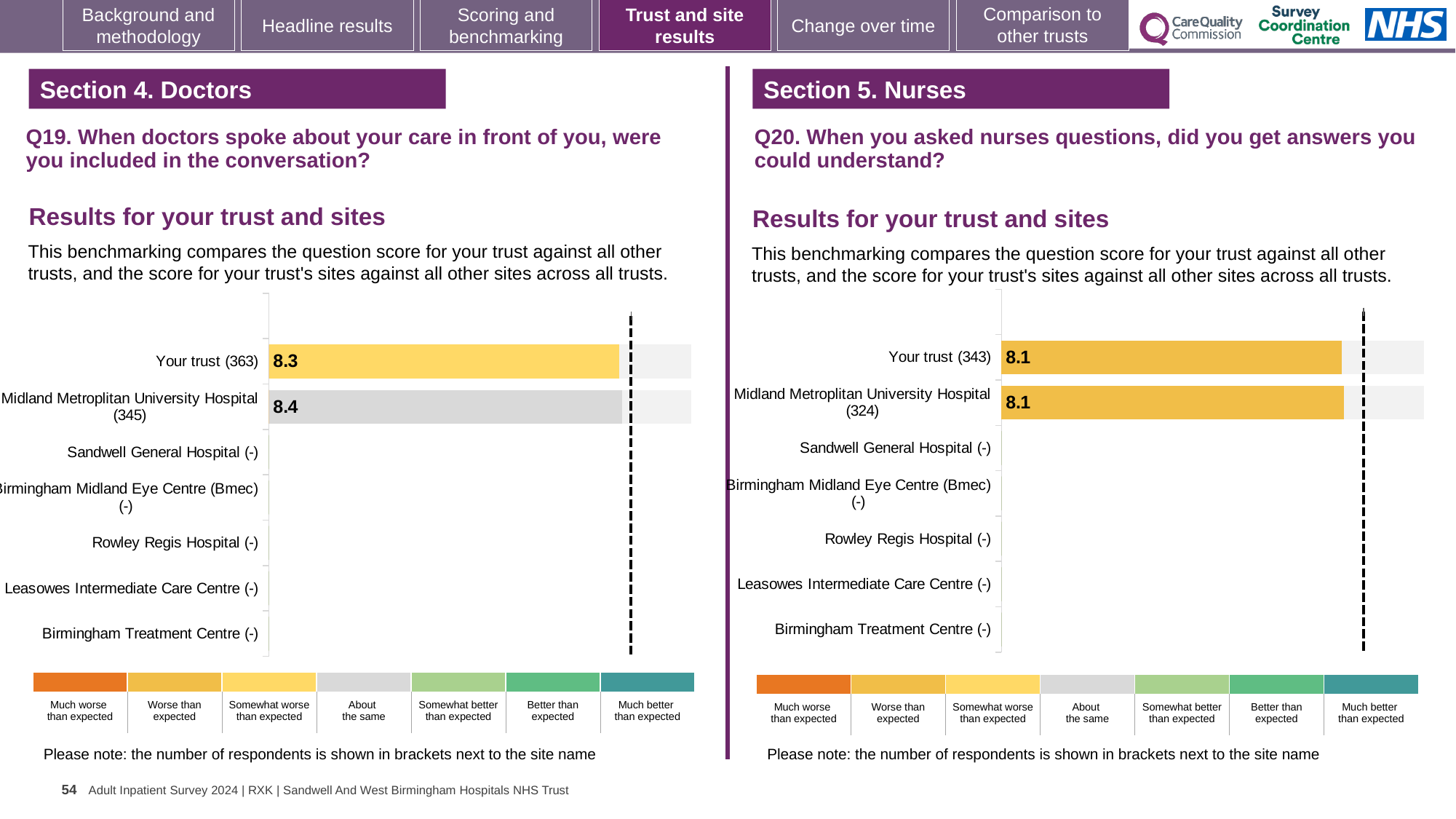
On the Q19 chart (left), what is the difference between the Midland Metropolitan University Hospital score and the Your trust score? 0.1 On the Q19 chart (left), how many sites have a plotted score bar? 2 On the Q20 chart (right), how many respondents are shown in brackets for Midland Metropolitan University Hospital? 324 On the Q19 chart (left), what is the score for Your trust? 8.3 On the Q19 chart (left), how many respondents are shown in brackets for Your trust? 363 On the Q19 chart (left), what is the score for Midland Metropolitan University Hospital? 8.4 On the Q20 chart (right), what is the score for Your trust? 8.1 On the Q19 chart (left), which has the higher score: Your trust or Midland Metropolitan University Hospital? Midland Metropolitan University Hospital On the Q20 chart (right), what is the score for Midland Metropolitan University Hospital? 8.1 How many site categories are listed on the Q19 chart (left)? 7 On the Q20 chart (right), what is the difference between the Your trust score and the Midland Metropolitan University Hospital score? 0 What type of chart is used for the Q20 results (right)? Bar chart